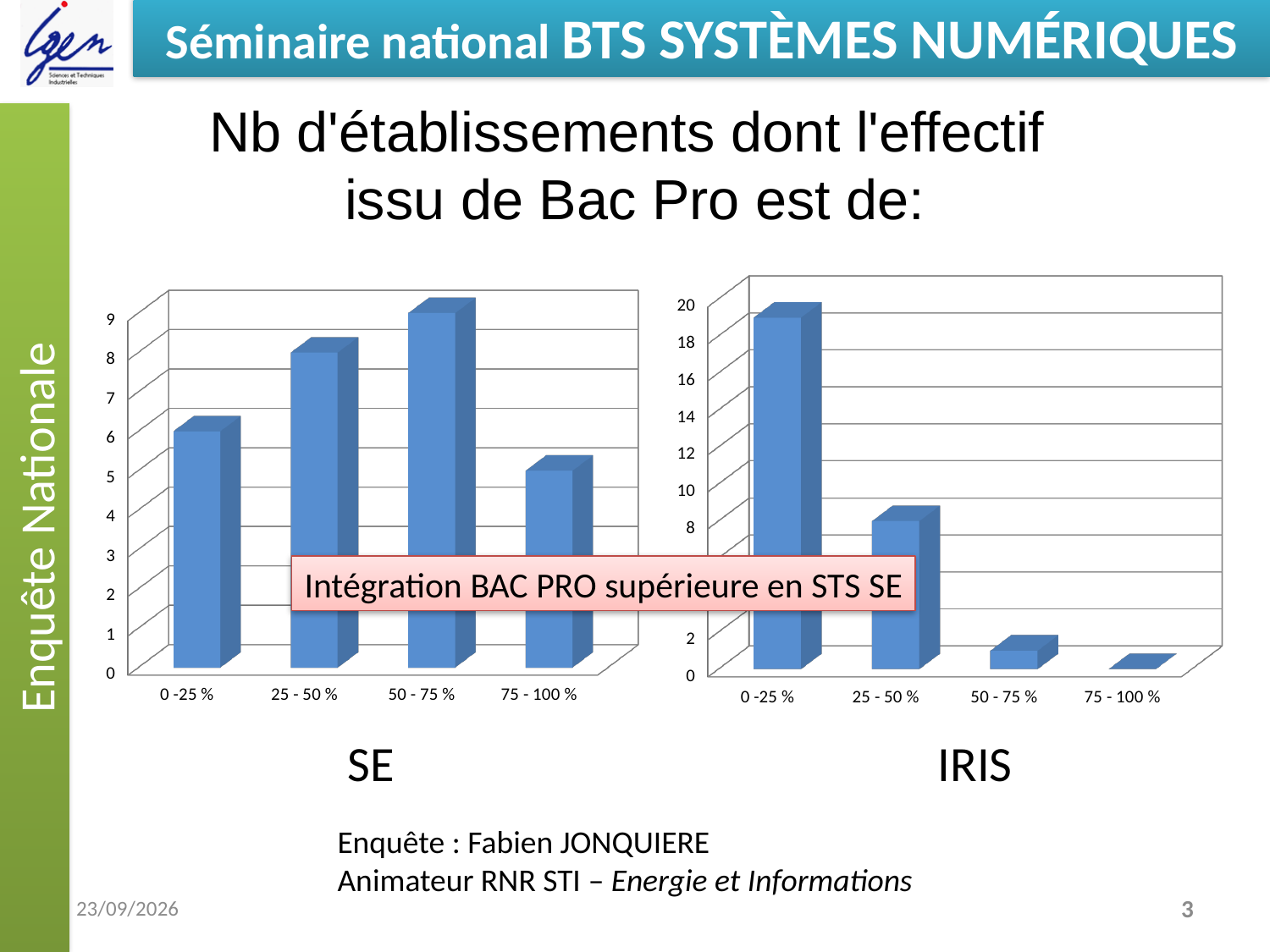
What kind of chart is the SE chart on the left of the slide? bar chart In the IRIS chart, is the value for 0 -25 % greater or less than 18? greater In the SE chart, which category has the highest value? 50 - 75 % In the IRIS chart, what is the value for the 25 - 50 % category? 8 What does the pink text box overlaid on the charts say? Intégration BAC PRO supérieure en STS SE In the SE chart, which category has the lowest value? 75 - 100 % How many categories are shown on the x axis of the SE chart? 4 In the SE chart, what is the value for the 25 - 50 % category? 8 In the SE chart, what is the value for the 50 - 75 % category? 9 In the IRIS chart, do the values rise or fall from left to right along the x axis? fall In the SE chart, which category has the larger value: 0 -25 % or 25 - 50 %? 25 - 50 % In the SE chart, what is the difference between the values for 50 - 75 % and 75 - 100 %? 4